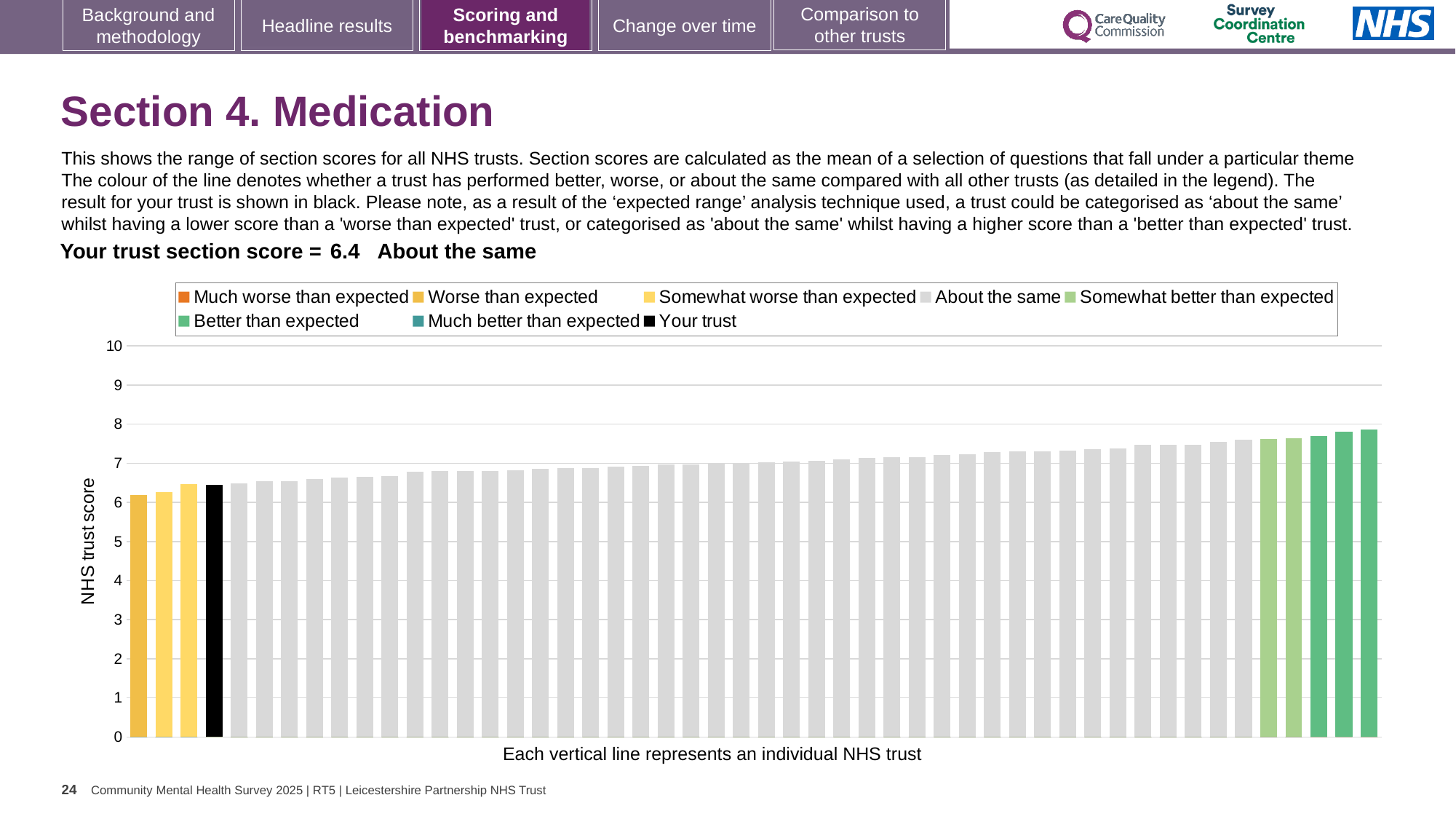
Is the value for your trust (the black bar) greater or less than 5? greater Is the value of the shortest bar greater or less than 6? greater What is the label on the vertical axis of the chart? NHS trust score Do the bar values rise or fall from left to right along the x axis? rise What kind of chart is shown on the slide? bar chart What is the section score for your trust shown on the slide? 6.4 Is the value for your trust (the black bar) greater or less than 7? less What colour is the bar representing your trust? black How many entries does the chart legend list? 8 How is your trust's section score categorised compared with other trusts? About the same